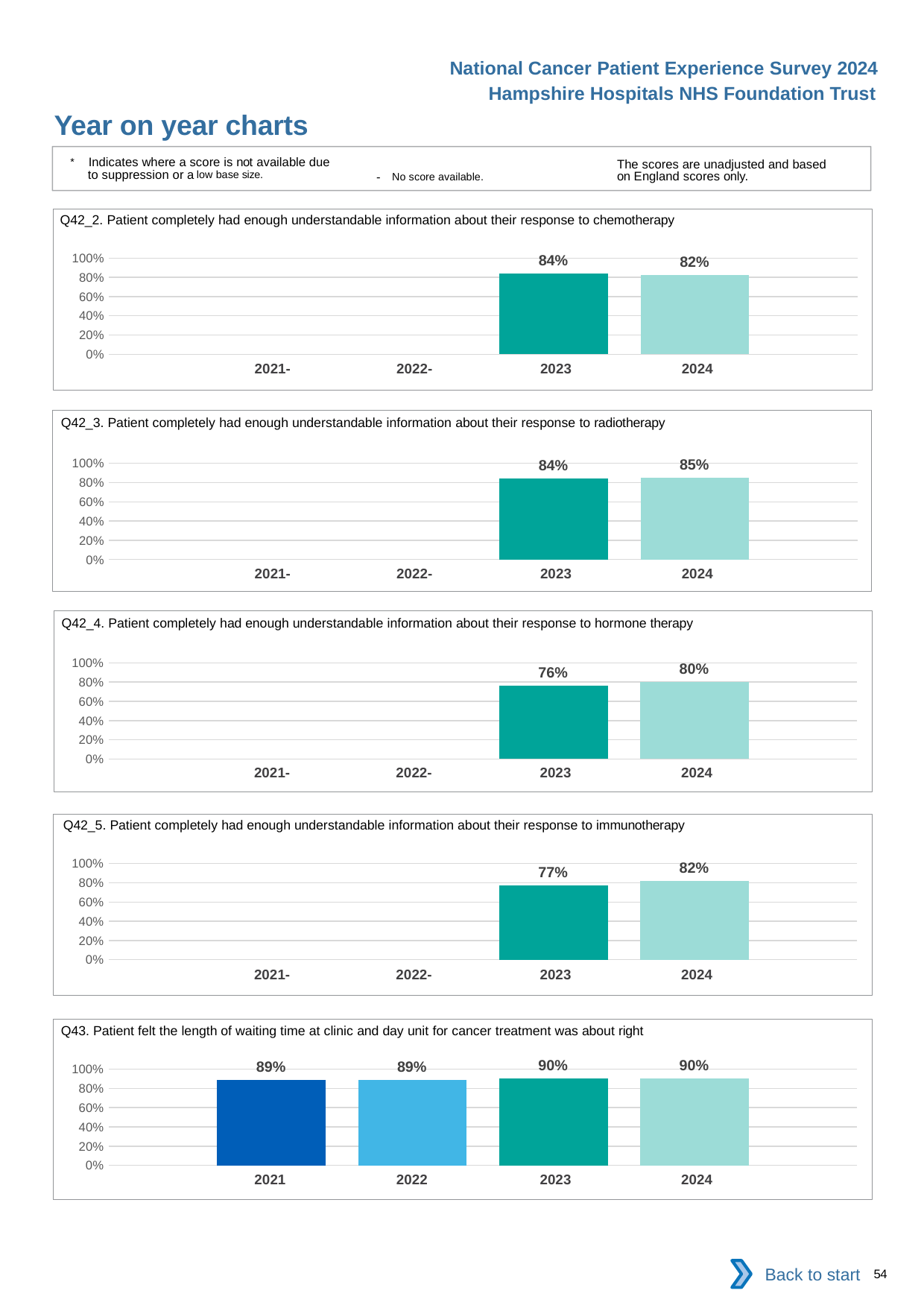
In the Q42_2 chart (chemotherapy), what is the value for 2024? 82% What kind of chart is the Q42_3 chart (radiotherapy)? bar chart In the Q42_5 chart (immunotherapy), what is the value for 2023? 77% How many charts are shown on the slide? 5 In the Q42_3 chart (radiotherapy), what is the value for 2024? 85% In the Q43 chart (waiting time at clinic and day unit), how many years have a bar plotted? 4 In the Q42_4 chart (hormone therapy), which year has the lower value, 2023 or 2024? 2023 In the Q43 chart (waiting time at clinic and day unit), do the values rise or fall from 2021 to 2024? rise In the Q42_2 chart (chemotherapy), what is the value for 2023? 84% In the Q43 chart (waiting time at clinic and day unit), what is the value for 2021? 89% In the Q42_4 chart (hormone therapy), what is the difference between the 2024 and 2023 values? 4% In the Q42_5 chart (immunotherapy), what is the difference between the 2024 and 2023 values? 5%